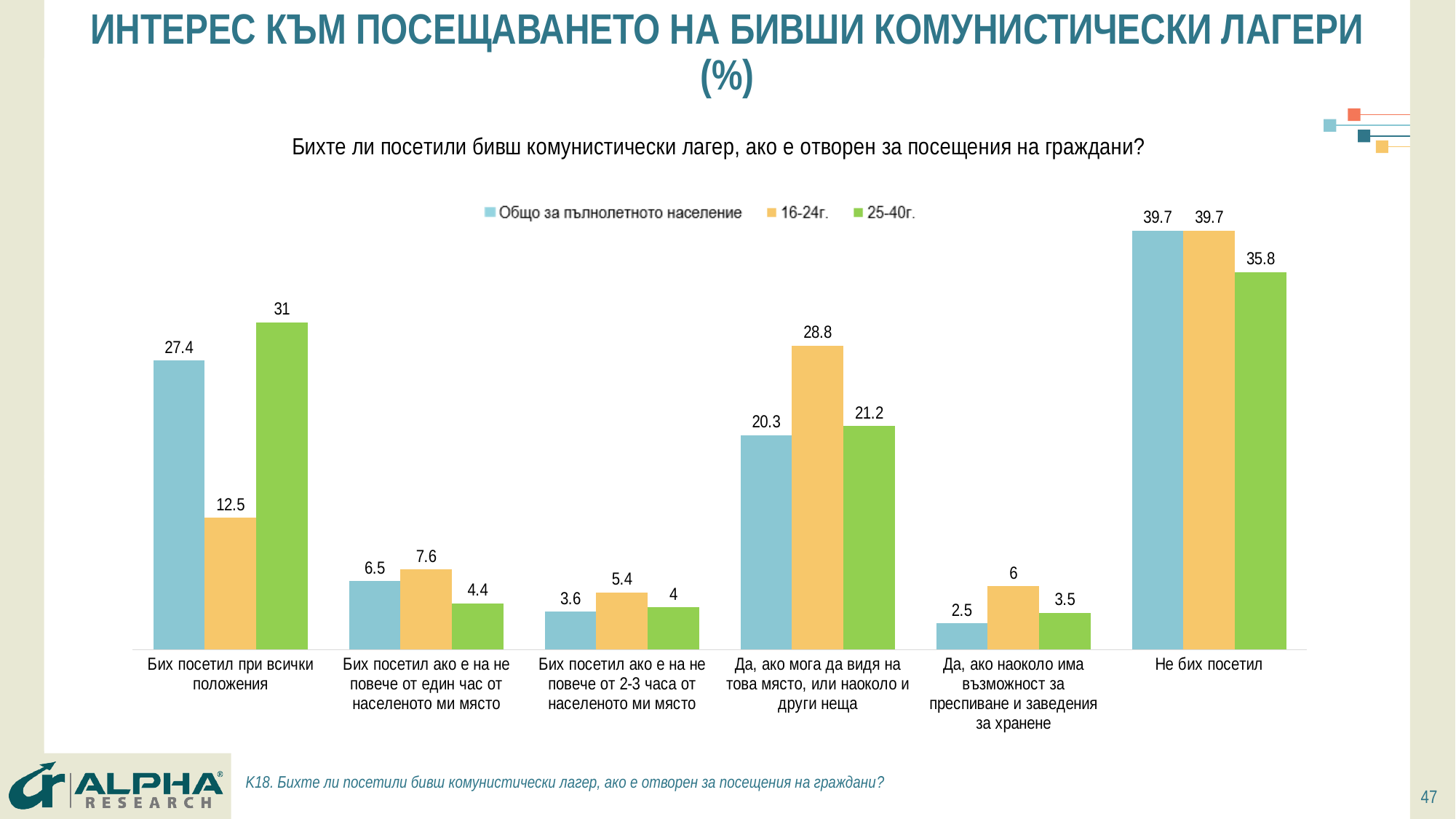
Which category has the lowest value for "Общо за пълнолетното население"? Да, ако наоколо има възможност за преспиване и заведения за хранене What is the value for the "16-24г." series in the category "Да, ако мога да видя на това място, или наоколо и други неща"? 28.8 What is the value for the "25-40г." series in the category "Не бих посетил"? 35.8 What is the value for the "16-24г." series in the category "Да, ако наоколо има възможност за преспиване и заведения за хранене"? 6 Which category has the highest value for the "25-40г." series? Не бих посетил What type of chart is shown on the slide? Bar chart How many series does the legend list? 3 Which series is shown in green in the chart legend? 25-40г. What is the difference between the "25-40г." and "16-24г." values in the category "Бих посетил при всички положения"? 18.5 In the category "Бих посетил ако е на не повече от един час от населеното ми място", which series has the larger value: "16-24г." or "25-40г."? 16-24г. How many categories are shown on the x axis of the chart? 6 What is the value for "Общо за пълнолетното население" in the category "Бих посетил при всички положения"? 27.4